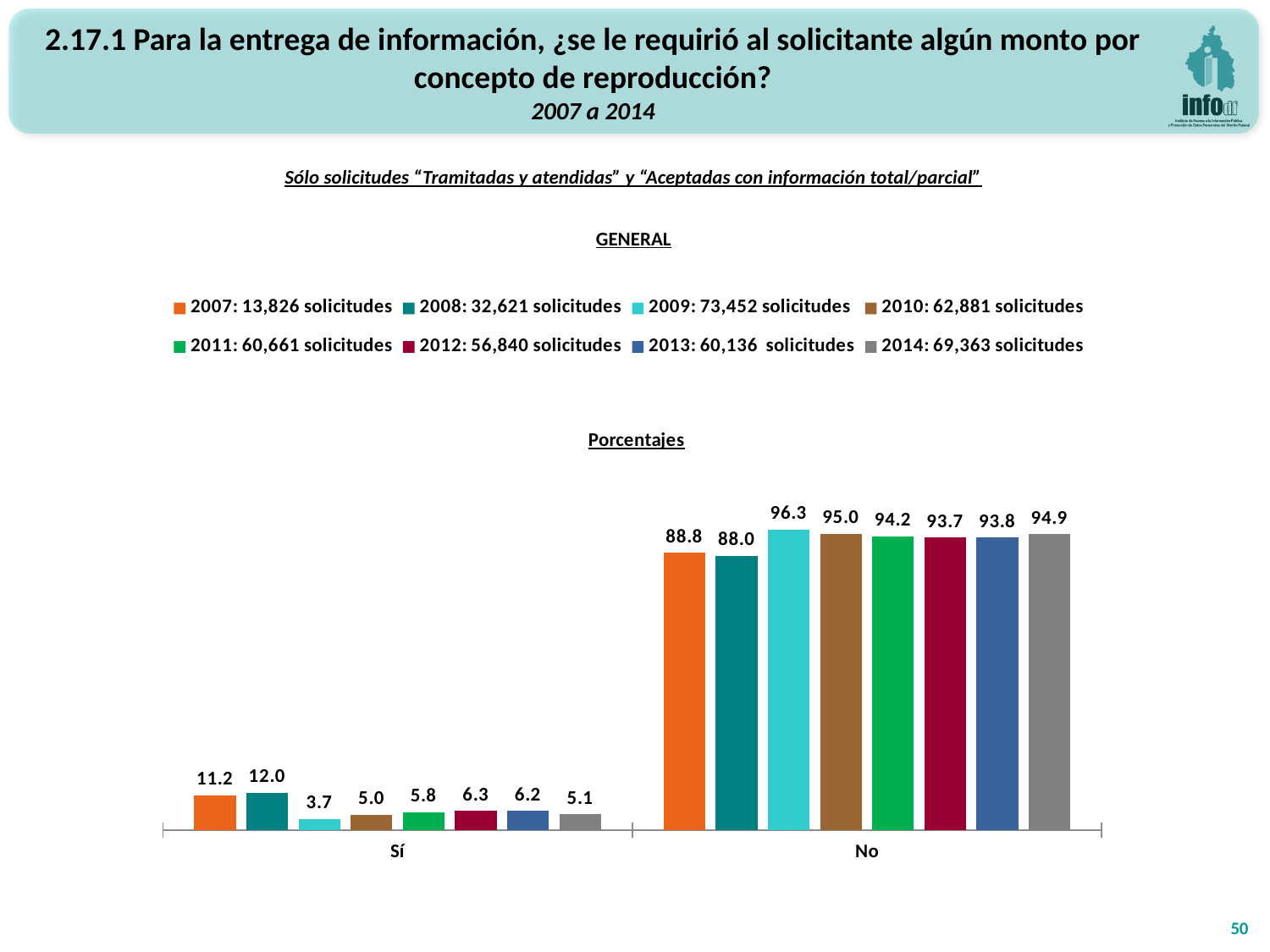
Which is larger in the "No" category: the value for 2010 or the value for 2012? 2010 What percentage is shown for 2009 in the "No" category? 96.3 What percentage is shown for 2007 in the "Sí" category? 11.2 According to the legend, how many solicitudes were there in 2009? 73,452 What is the difference between the 2008 and 2009 values in the "Sí" category? 8.3 Which year has the lowest value in the "Sí" category? 2009 Which year has the lowest value in the "No" category? 2008 How many categories are shown on the x axis? 2 What is the value for 2014 in the "No" category? 94.9 Which year has the highest value in the "Sí" category? 2008 What kind of chart is shown on the slide? Bar chart How many series does the legend list? 8